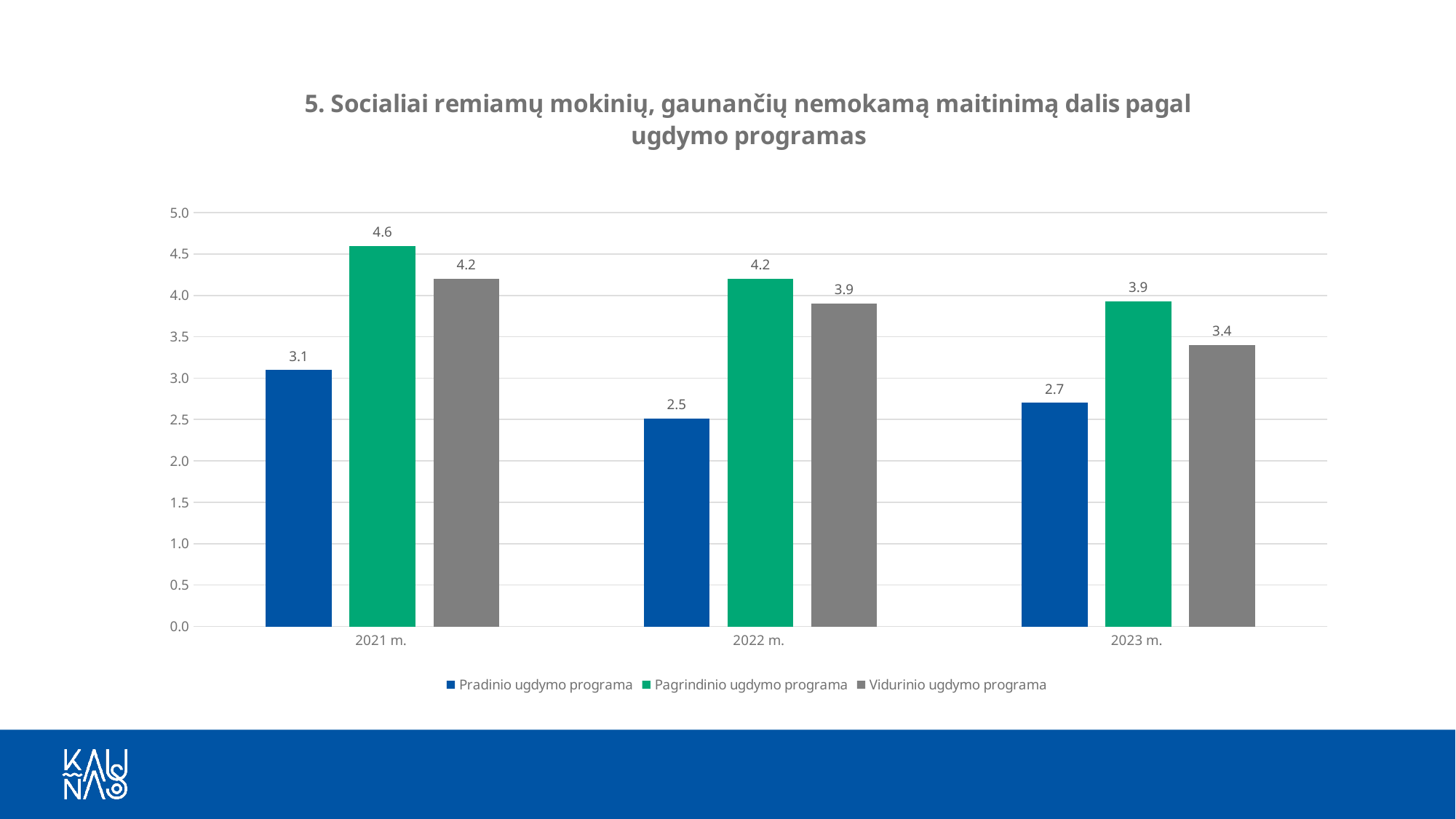
What is the value for Pradinio ugdymo programa in 2021 m.? 3.1 Does the value for Vidurinio ugdymo programa rise or fall from 2021 m. to 2023 m.? fall What kind of chart is shown on the slide? bar chart Which is larger in 2023 m.: Pagrindinio ugdymo programa or Vidurinio ugdymo programa? Pagrindinio ugdymo programa What is the value for Pagrindinio ugdymo programa in 2022 m.? 4.2 What is the difference between Pagrindinio ugdymo programa and Pradinio ugdymo programa in 2021 m.? 1.5 Is the value for Pradinio ugdymo programa in 2022 m. greater or less than 3.0? less How many series does the legend list? 3 Which year has the lowest value for Pradinio ugdymo programa? 2022 m. What is the value for Vidurinio ugdymo programa in 2023 m.? 3.4 How many years are shown on the x axis? 3 Which year has the highest value for Pagrindinio ugdymo programa? 2021 m.